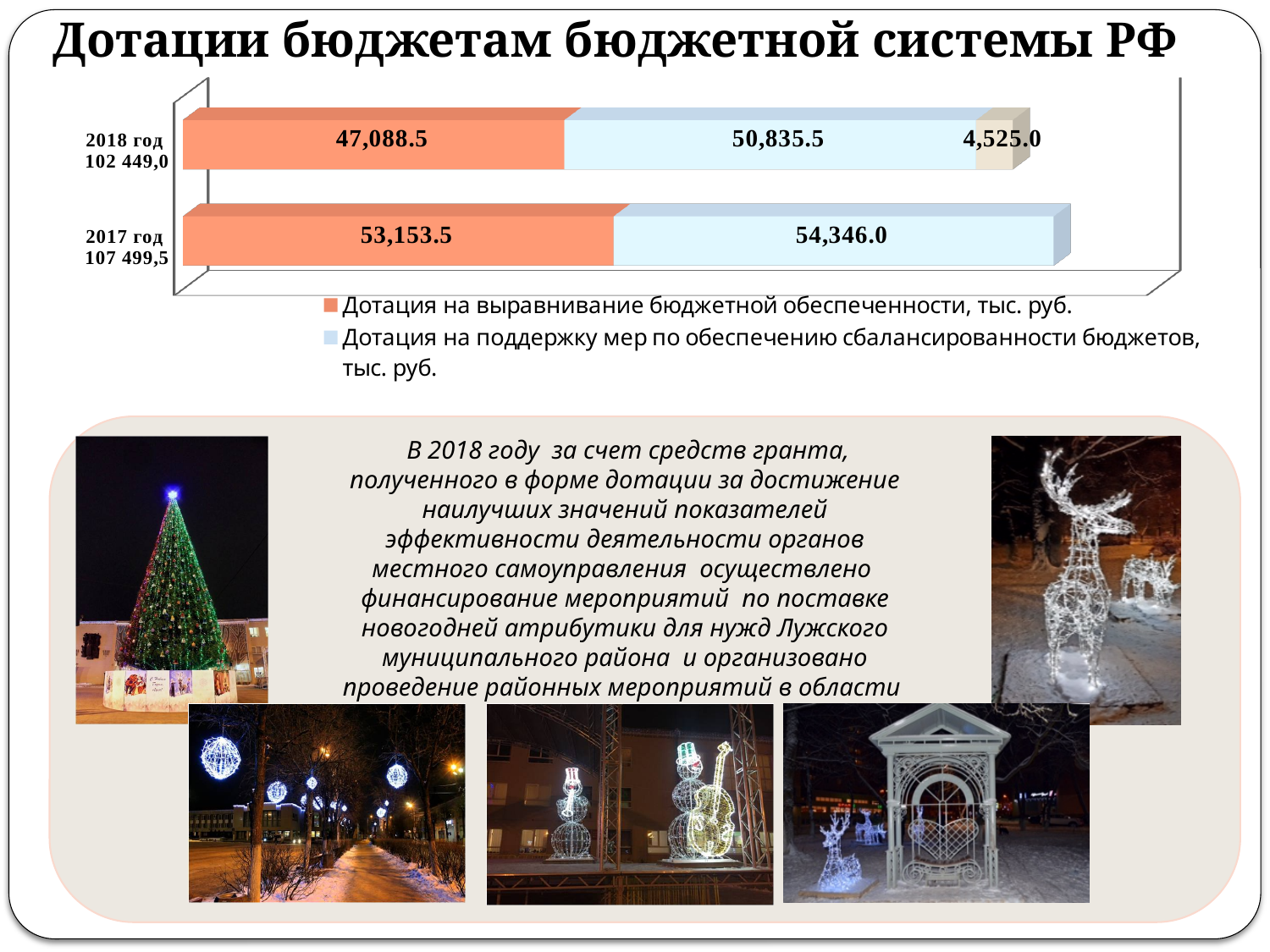
What is the value of 'Дотация на выравнивание бюджетной обеспеченности' for 2018 год? 47,088.5 What is the value of 'Дотация на поддержку мер по обеспечению сбалансированности бюджетов' for 2017 год? 54,346.0 What is the value of 'Дотация на выравнивание бюджетной обеспеченности' for 2017 год? 53,153.5 What type of chart is shown on the slide? Stacked bar chart What is the value of 'Дотация на поддержку мер по обеспечению сбалансированности бюджетов' for 2018 год? 50,835.5 How many years (categories) are shown in the chart? 2 By how much does 'Дотация на выравнивание бюджетной обеспеченности' in 2017 год exceed that in 2018 год? 6,065.0 How many series does the legend list? 2 Which year has the larger value for 'Дотация на выравнивание бюджетной обеспеченности', 2017 год or 2018 год? 2017 год What is the difference between the 2017 and 2018 values of 'Дотация на поддержку мер по обеспечению сбалансированности бюджетов'? 3,510.5 What value is shown on the third (rightmost) segment of the 2018 год bar? 4,525.0 What total is printed next to the 2018 год category label? 102 449,0